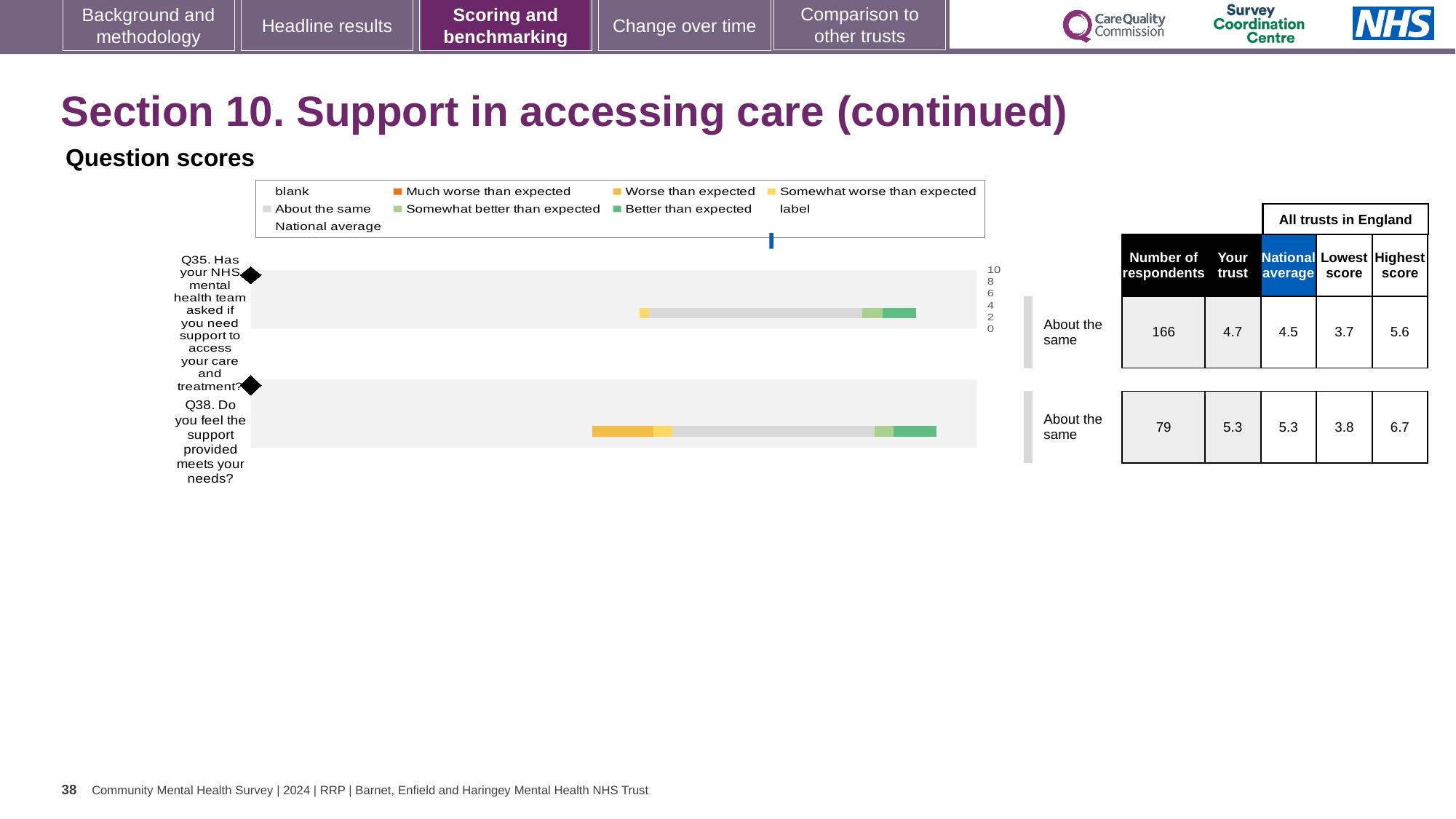
What is the 'Your trust' score for Q38? 5.3 What kind of chart is shown under 'Question scores'? bar chart Which question has the higher 'Your trust' score, Q35 or Q38? Q38 What is the national average for Q35? 4.5 What is the 'Your trust' score for Q35? 4.7 What benchmark category is shown for both Q35 and Q38? About the same What is the lowest score among all trusts in England for Q35? 3.7 What is the highest score among all trusts in England for Q38? 6.7 Which is larger for Q35, the 'Your trust' score or the national average? Your trust How many questions are plotted in the chart? 2 How many respondents answered Q38? 79 What is the difference between the highest and lowest scores for Q38? 2.9